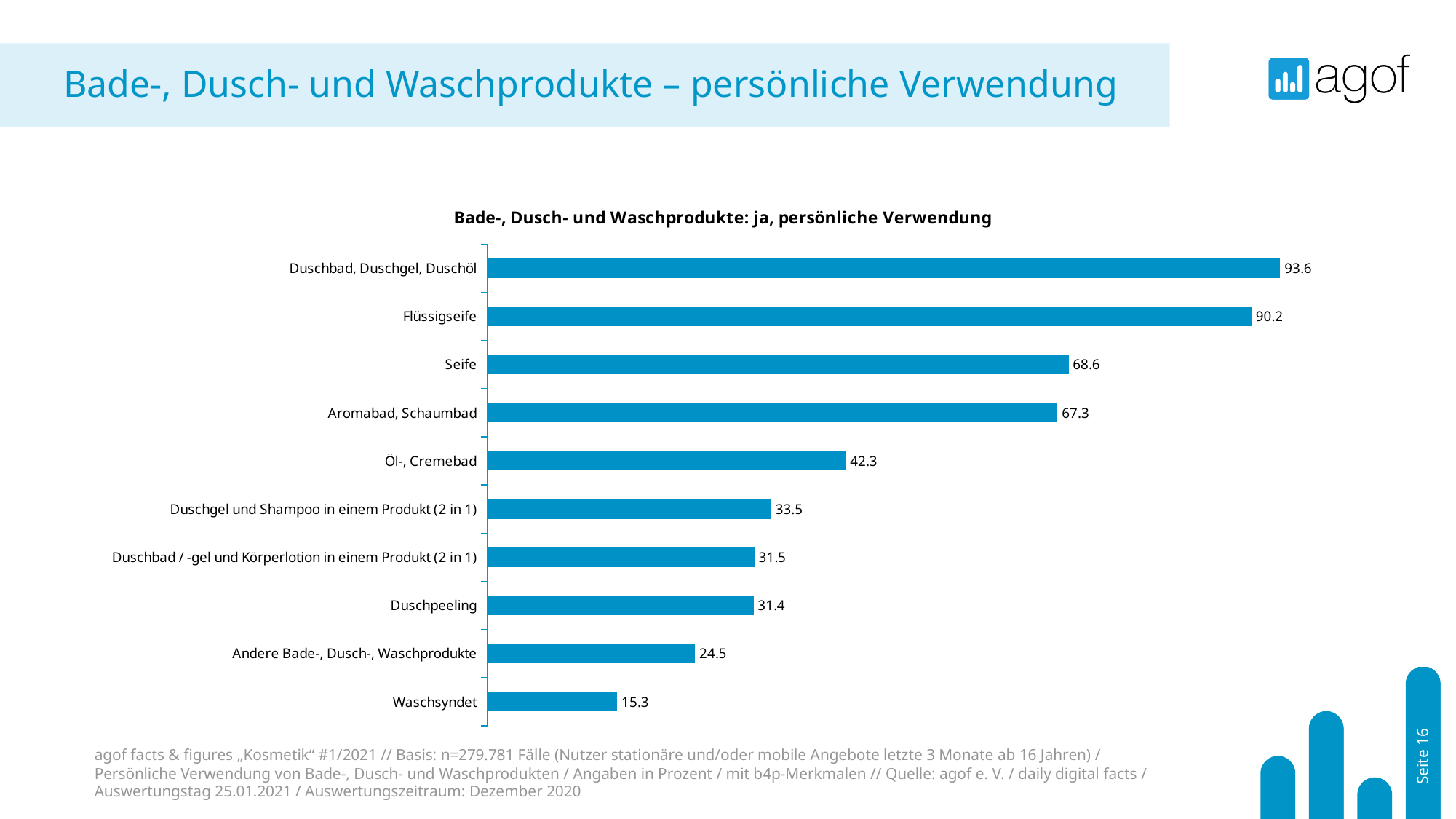
What is the value for Duschbad / -gel und Körperlotion in einem Produkt (2 in 1)? 31.5 Which category has the highest value? Duschbad, Duschgel, Duschöl What is the difference between the values for Seife and Aromabad, Schaumbad? 1.3 Which is larger, the value for Duschgel und Shampoo in einem Produkt (2 in 1) or the value for Andere Bade-, Dusch-, Waschprodukte? Duschgel und Shampoo in einem Produkt (2 in 1) What is the value for Öl-, Cremebad? 42.3 What is the value for Duschpeeling? 31.4 How many categories are shown in the chart? 10 Which category has the lowest value? Waschsyndet What is the title of the chart? Bade-, Dusch- und Waschprodukte: ja, persönliche Verwendung What is the difference between the values for Duschbad, Duschgel, Duschöl and Waschsyndet? 78.3 What is the value for Flüssigseife? 90.2 What kind of chart is shown on the slide? Bar chart